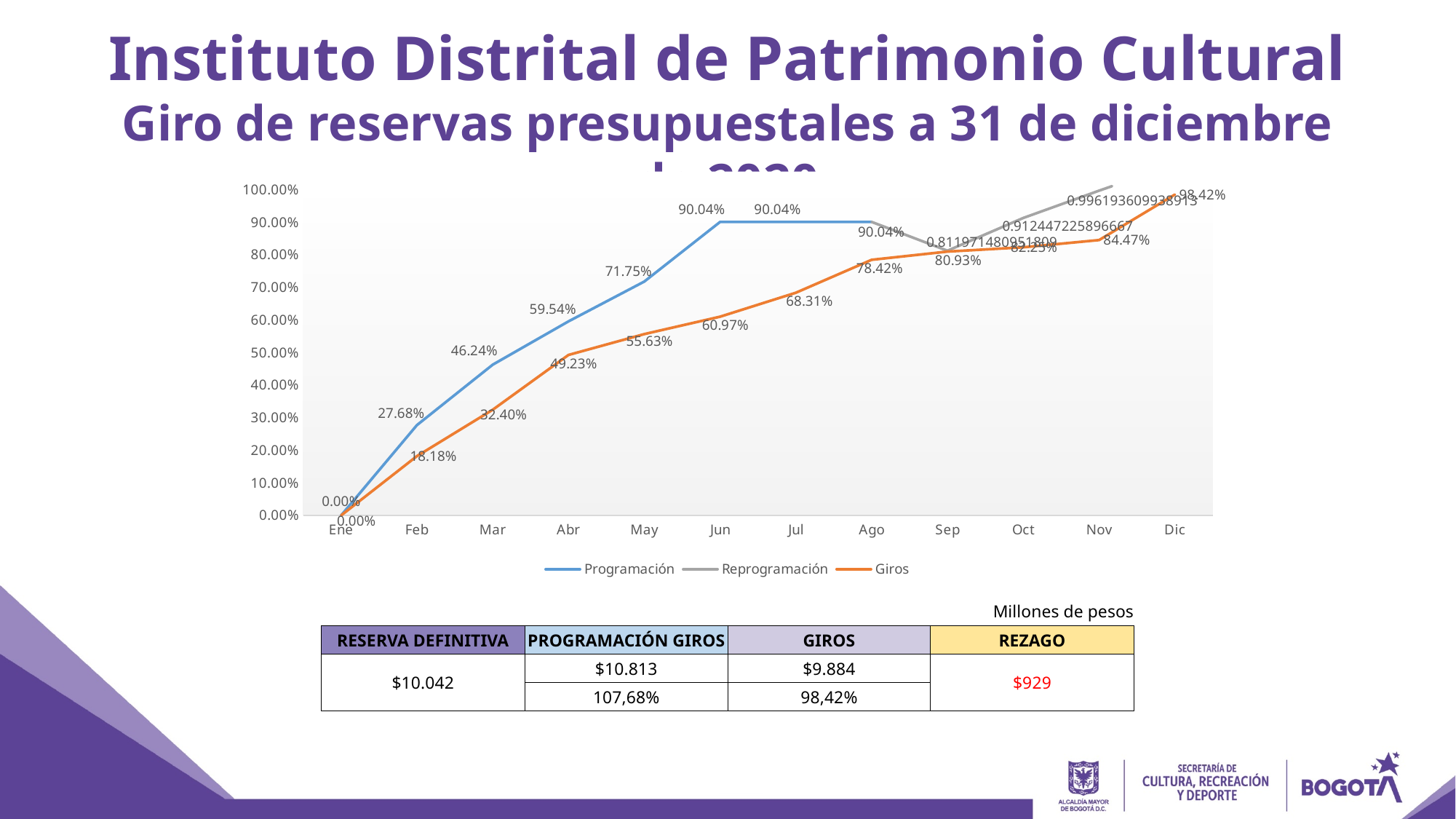
Which series is drawn in orange in the chart? Giros What is the difference between the Programación value and the Giros value in Mar? 13.84% What is the Giros value for Dic? 98.42% What is the Giros value for Feb? 18.18% What is the Giros value for Ago? 78.42% What is the Programación value for Jun? 90.04% How many months are shown on the x axis of the chart? 12 Which is larger in May, the Programación value or the Giros value? Programación What is the Programación value for Abr? 59.54% Does the Giros series rise or fall from Ene to Dic? rise How many series does the chart legend list? 3 What type of chart is shown on the slide? line chart